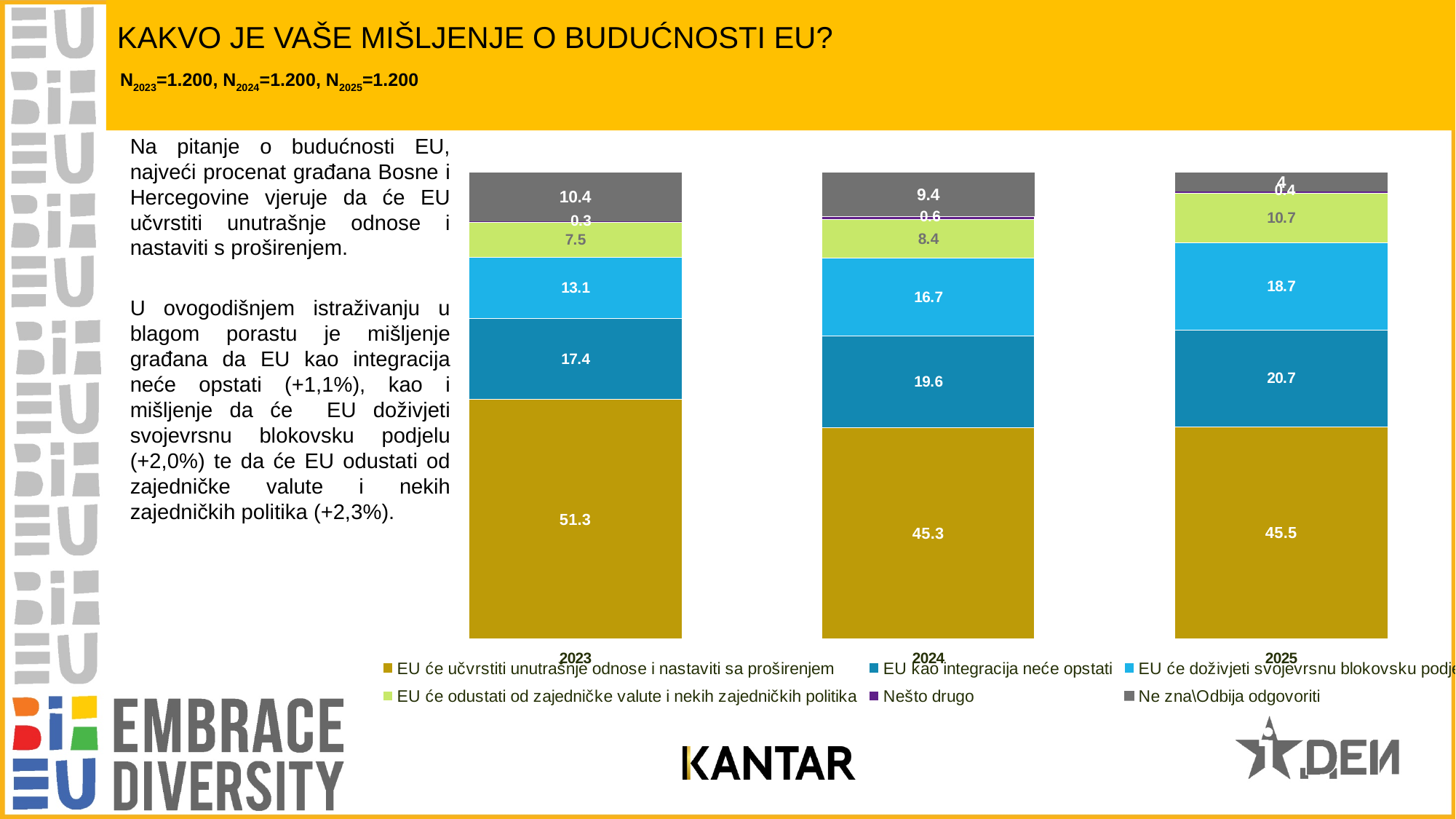
In which year is the value for "EU će učvrstiti unutrašnje odnose i nastaviti sa proširenjem" highest? 2023 What kind of chart is shown on the slide? Stacked bar chart How many series does the legend list? 6 What is the value for "Ne zna\Odbija odgovoriti" in 2024? 9.4 Does the value for "EU kao integracija neće opstati" rise or fall from 2023 to 2025? Rise How many years are shown on the x axis of the chart? 3 What is the value for "EU kao integracija neće opstati" in 2025? 20.7 Which year has the larger value for "EU će odustati od zajedničke valute i nekih zajedničkih politika", 2023 or 2025? 2025 What is the difference between the 2024 and 2023 values for "EU kao integracija neće opstati"? 2.2 What is the value for "EU će odustati od zajedničke valute i nekih zajedničkih politika" in 2024? 8.4 What is the value for "EU će učvrstiti unutrašnje odnose i nastaviti sa proširenjem" in 2023? 51.3 What is the value for "Nešto drugo" in 2023? 0.3